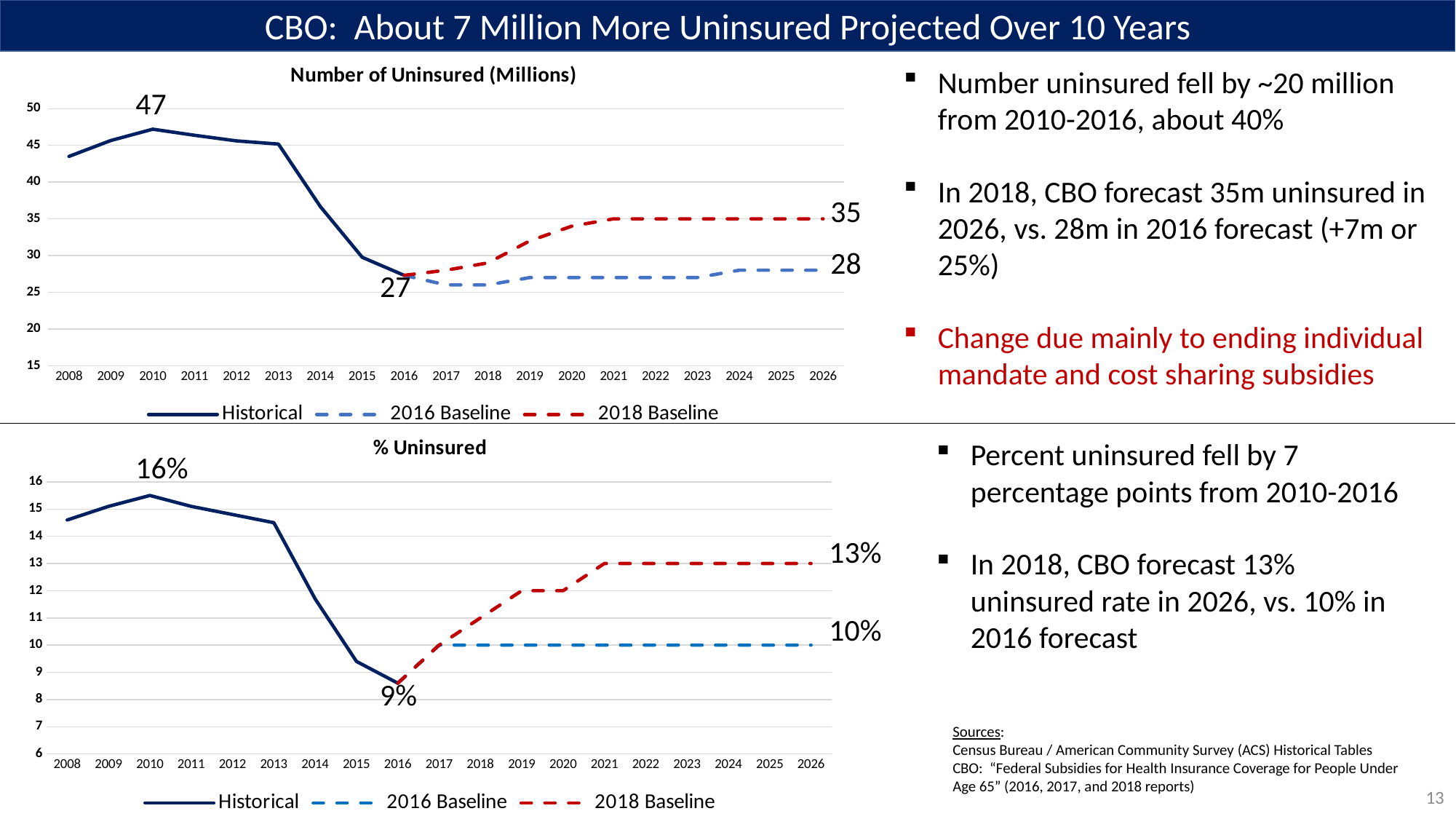
In the 'Number of Uninsured (Millions)' chart, is the Historical value for 2014 greater or less than 40? less In the 'Number of Uninsured (Millions)' chart, does the Historical line rise or fall from 2013 to 2016? fall In the 'Number of Uninsured (Millions)' chart, what is the Historical value labelled for 2010? 47 In the 'Number of Uninsured (Millions)' chart, what value does the 2016 Baseline reach in 2026? 28 In the '% Uninsured' chart, what is the difference between the 2018 Baseline and 2016 Baseline values in 2026? 3 percentage points In the '% Uninsured' chart, what is the Historical value labelled for 2016? 9% In the 'Number of Uninsured (Millions)' chart, how many series does the legend list? 3 In the 'Number of Uninsured (Millions)' chart, what value does the 2018 Baseline reach in 2026? 35 In the '% Uninsured' chart, what is the Historical value labelled for 2010? 16% In the 'Number of Uninsured (Millions)' chart, what is the difference between the 2018 Baseline and 2016 Baseline values in 2026? 7 What type of chart is the '% Uninsured' chart? Line chart In the '% Uninsured' chart, which series is higher in 2026, the 2018 Baseline or the 2016 Baseline? 2018 Baseline